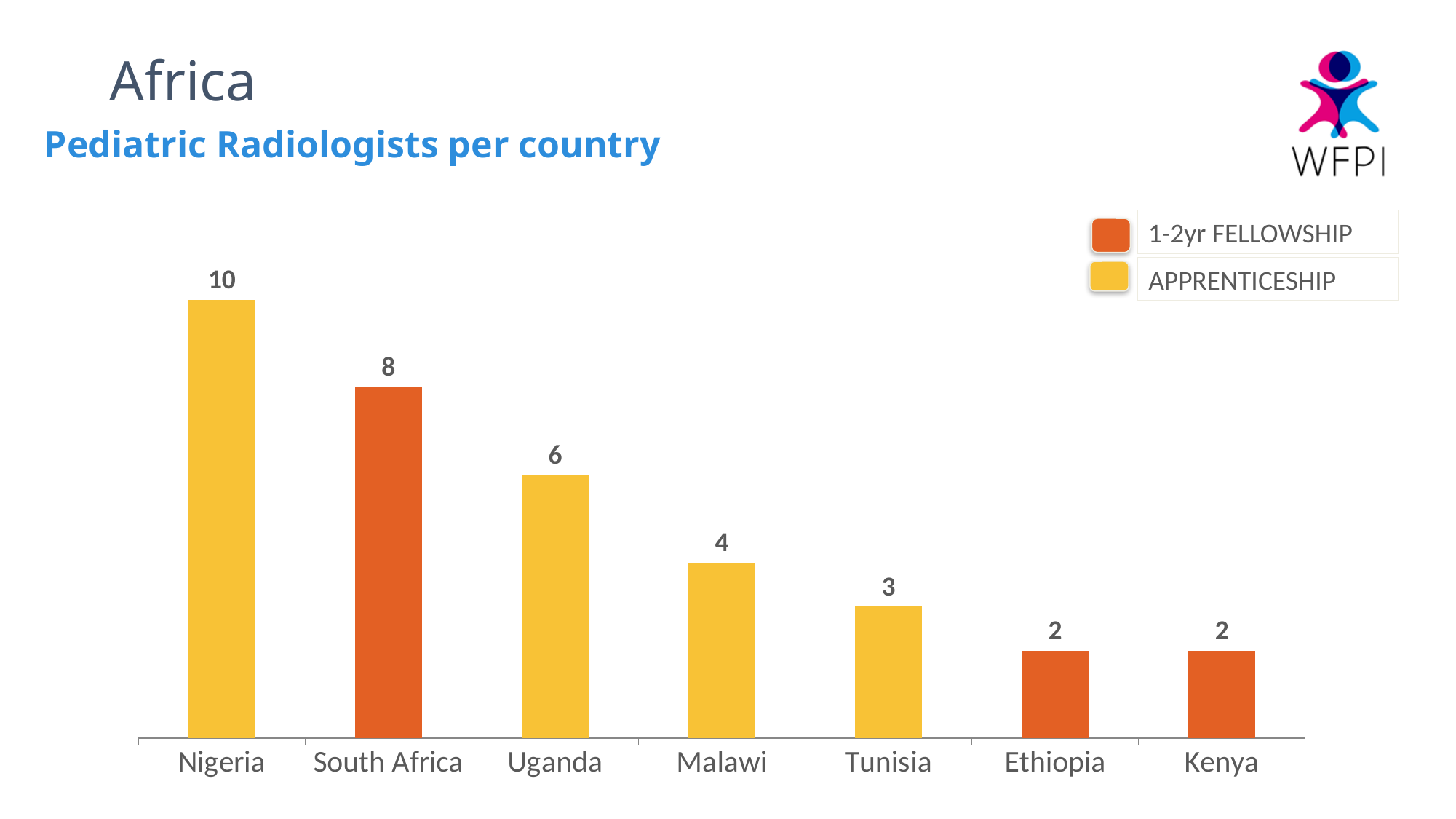
What kind of chart is shown on the slide? Bar chart What is the value shown for South Africa? 8 Do the values rise or fall from left to right across the countries? Fall Which training type does the orange colour represent in the legend? 1-2yr FELLOWSHIP How many countries are shown on the chart? 7 What is the value shown for Malawi? 4 How many entries does the legend list? 2 What is the difference between the values for Nigeria and Uganda? 4 Which country has the highest number of pediatric radiologists? Nigeria Which countries share the lowest value on the chart? Ethiopia and Kenya How many pediatric radiologists does Nigeria have according to the chart? 10 Which has a larger value, Uganda or Tunisia? Uganda